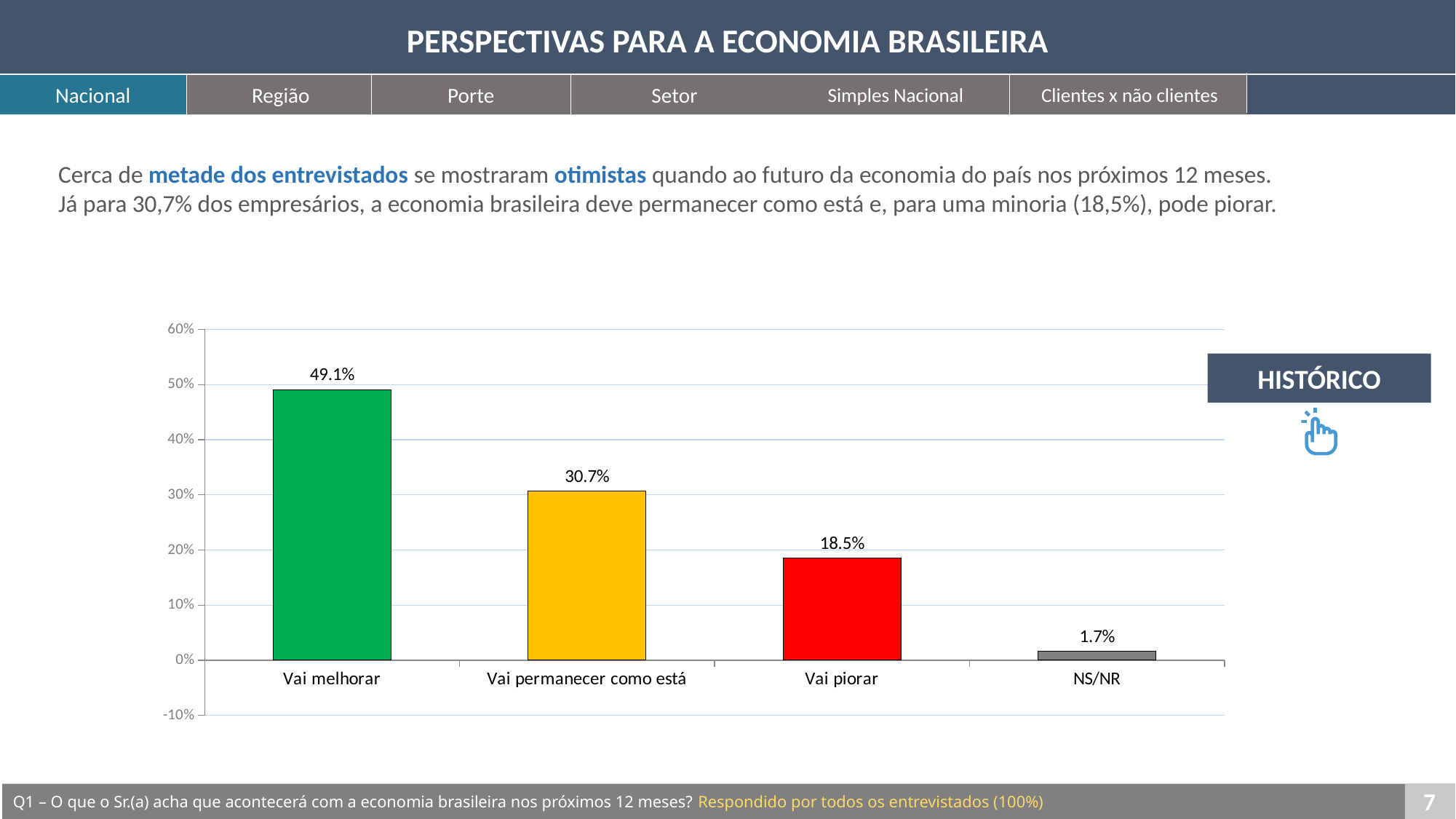
What is the value for "Vai melhorar"? 49.1% What is the difference between the values for "Vai melhorar" and "Vai permanecer como está"? 18.4% What kind of chart is shown on the slide? Bar chart Which category has the highest value? Vai melhorar Which is larger, the value for "Vai permanecer como está" or the value for "Vai piorar"? Vai permanecer como está What is the value for "Vai permanecer como está"? 30.7% What colour is the bar for "Vai piorar"? Red What is the value for "NS/NR"? 1.7% Which category has the lowest value? NS/NR What is the value for "Vai piorar"? 18.5% How many categories are shown on the x axis? 4 What is the difference between the values for "Vai piorar" and "NS/NR"? 16.8%